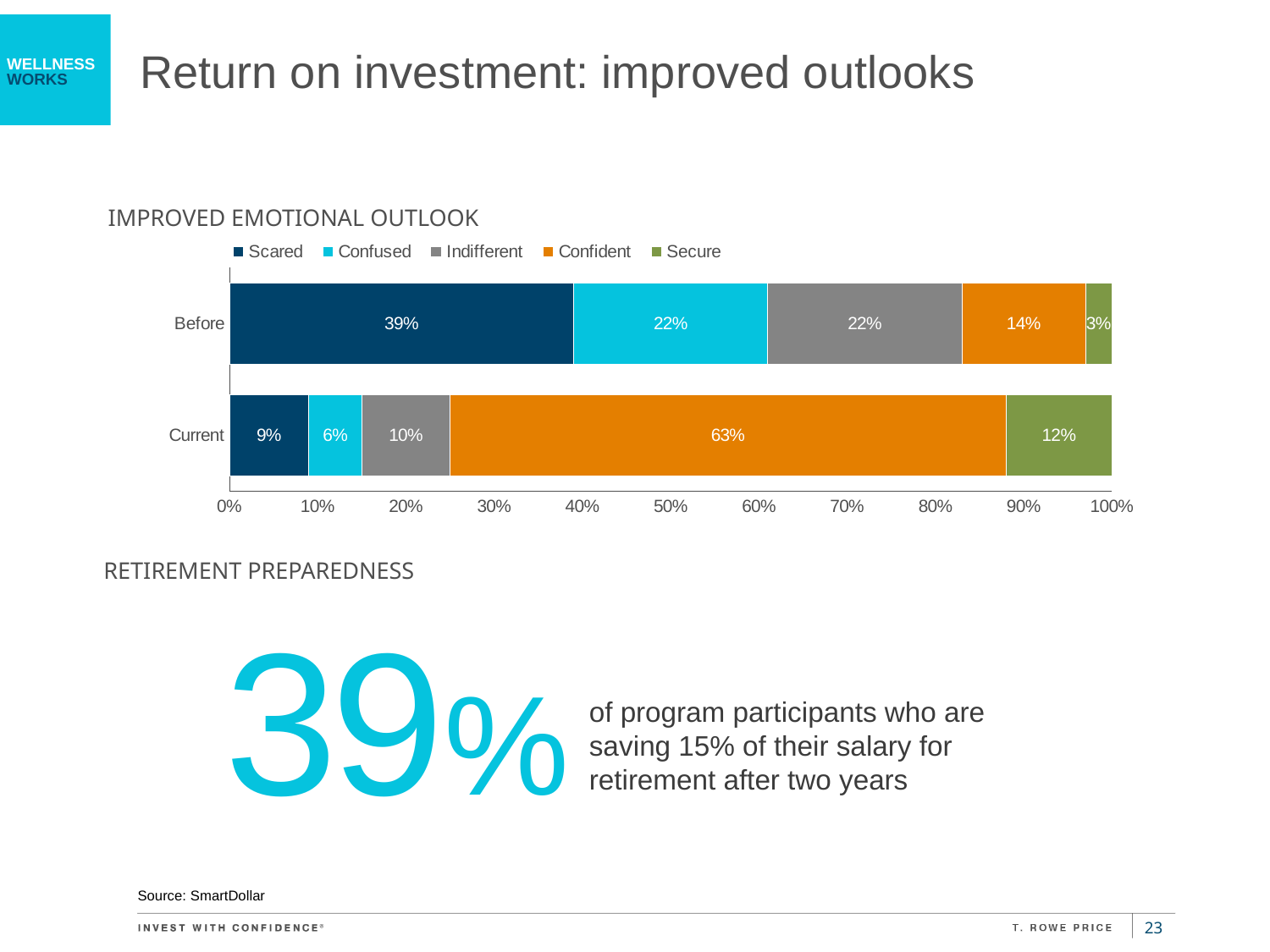
How many bars are shown in the chart? 2 Which series has the largest segment in the Current bar? Confident What is the Secure value in the Before bar? 3% What percentage of respondents were Scared in the Before bar? 39% What is the Confused value in the Current bar? 6% Which is larger: the Scared share in the Before bar or the Scared share in the Current bar? Before By how many percentage points did the Confident share increase from Before to Current? 49 What type of chart is used to show the improved emotional outlook? Stacked bar chart Which series has the smallest segment in the Before bar? Secure What is the Confident value for the Current bar? 63% What is the total of the segments in the Current bar? 100% How many series does the legend list? 5